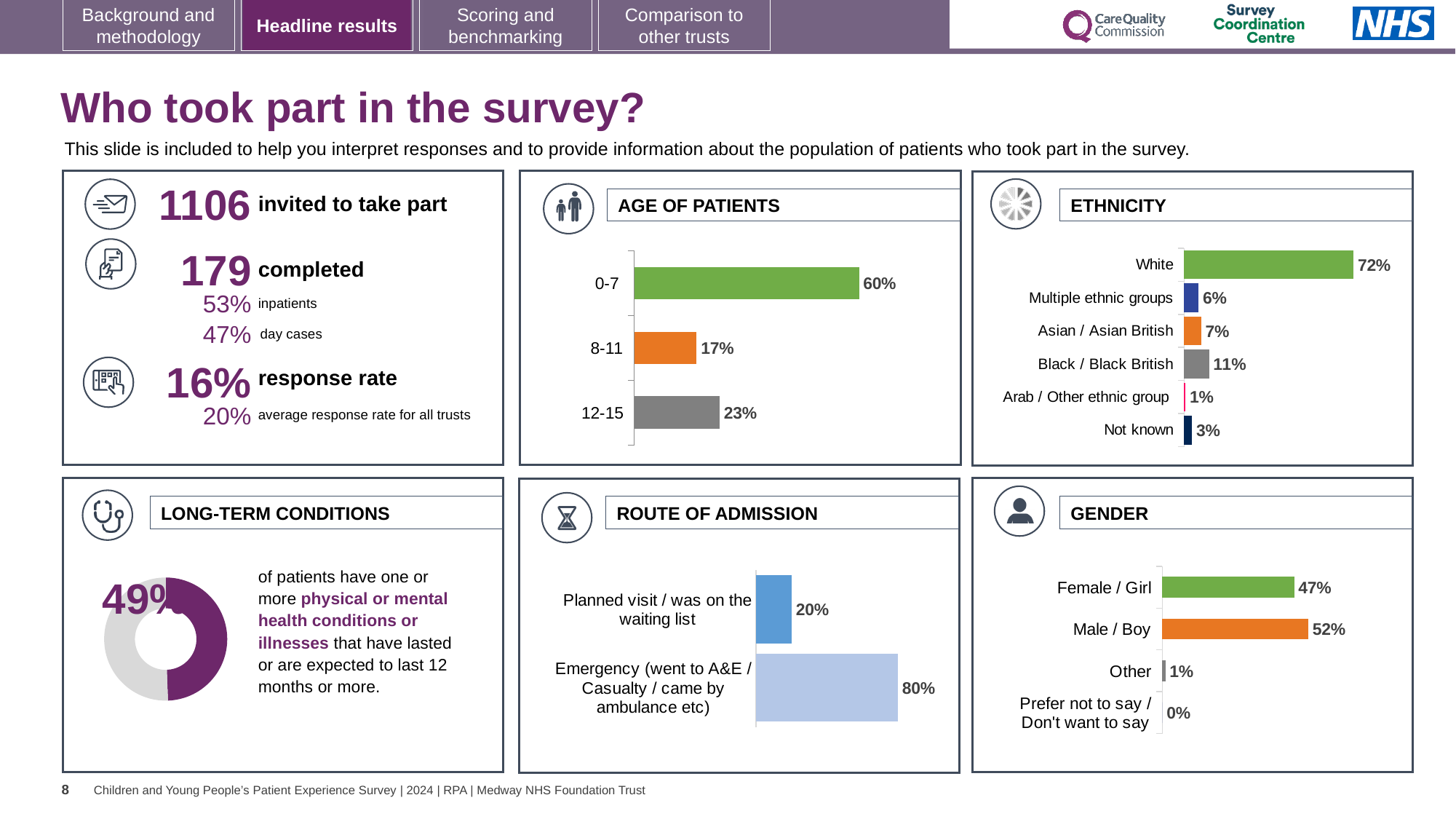
In the AGE OF PATIENTS chart, which age group has the lowest value? 8-11 In the GENDER chart, which is larger: Female / Girl or Male / Boy? Male / Boy In the AGE OF PATIENTS chart, what is the difference between the 0-7 and 12-15 values? 37% In the ETHNICITY chart, which category has the highest value? White In the ETHNICITY chart, which is larger: Asian / Asian British or Multiple ethnic groups? Asian / Asian British In the ROUTE OF ADMISSION chart, what is the value for Emergency (went to A&E / Casualty / came by ambulance etc)? 80% In the AGE OF PATIENTS chart, what is the value for the 0-7 age group? 60% In the GENDER chart, what is the value for Male / Boy? 52% What kind of chart is used in the LONG-TERM CONDITIONS panel? Doughnut chart In the ETHNICITY chart, what is the value for Black / Black British? 11% In the ROUTE OF ADMISSION chart, what is the difference between the Emergency and Planned visit values? 60% In the ETHNICITY chart, how many categories are shown? 6